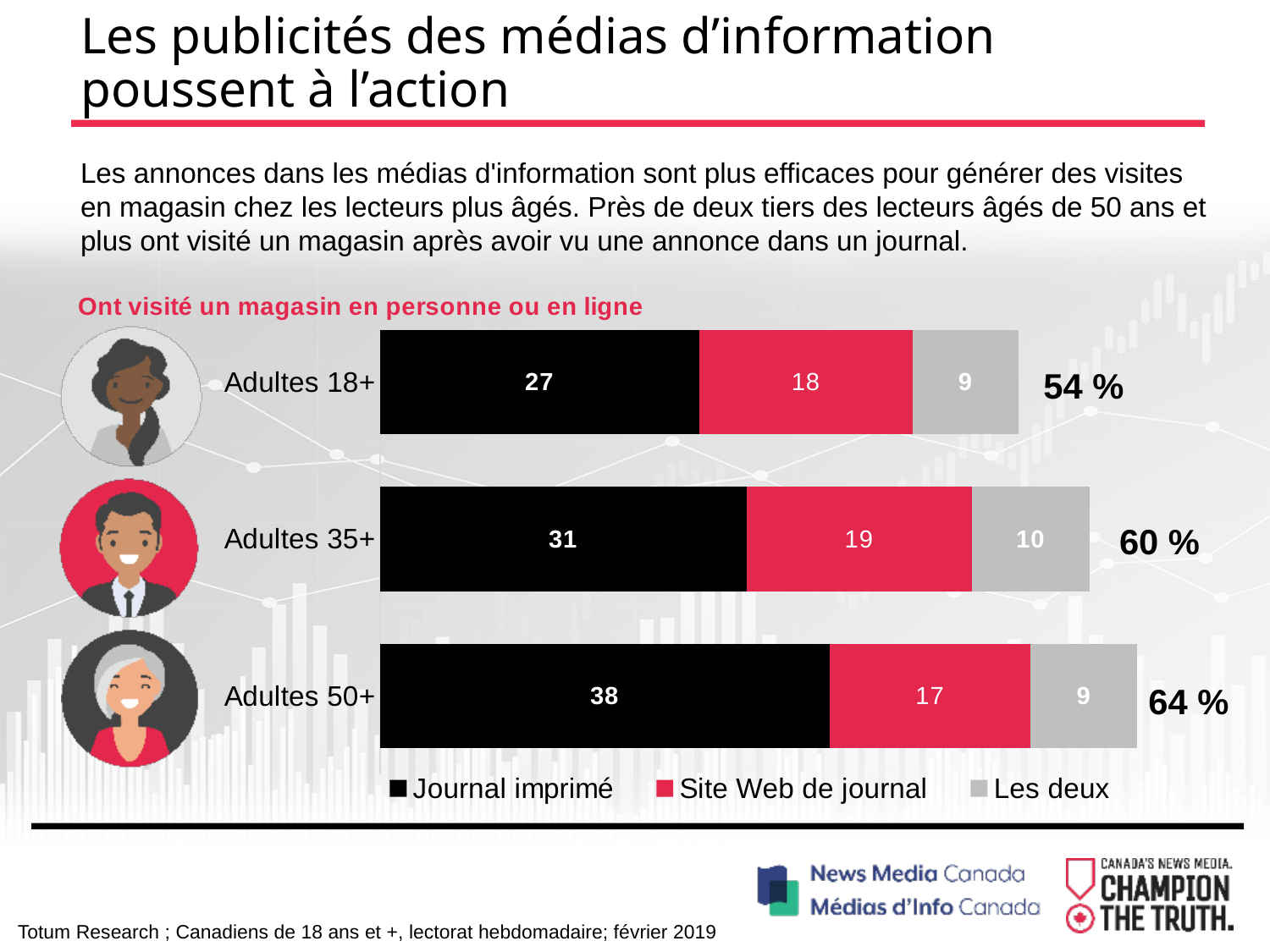
Which is larger: the Site Web de journal value for Adultes 35+ or for Adultes 50+? Adultes 35+ What is the value for Les deux for Adultes 18+? 9 What is the difference between the Journal imprimé values for Adultes 50+ and Adultes 18+? 11 Which age group has the lowest value for Journal imprimé? Adultes 18+ What is the total shown for the Adultes 35+ bar? 60 % What kind of chart is shown on the slide? Stacked bar chart Which age group has the highest value for Journal imprimé? Adultes 50+ What is the value for Journal imprimé for Adultes 50+? 38 How many age groups are shown in the chart? 3 What is the value for Site Web de journal for Adultes 35+? 19 How many series does the legend list? 3 What is the total shown for the Adultes 50+ bar? 64 %